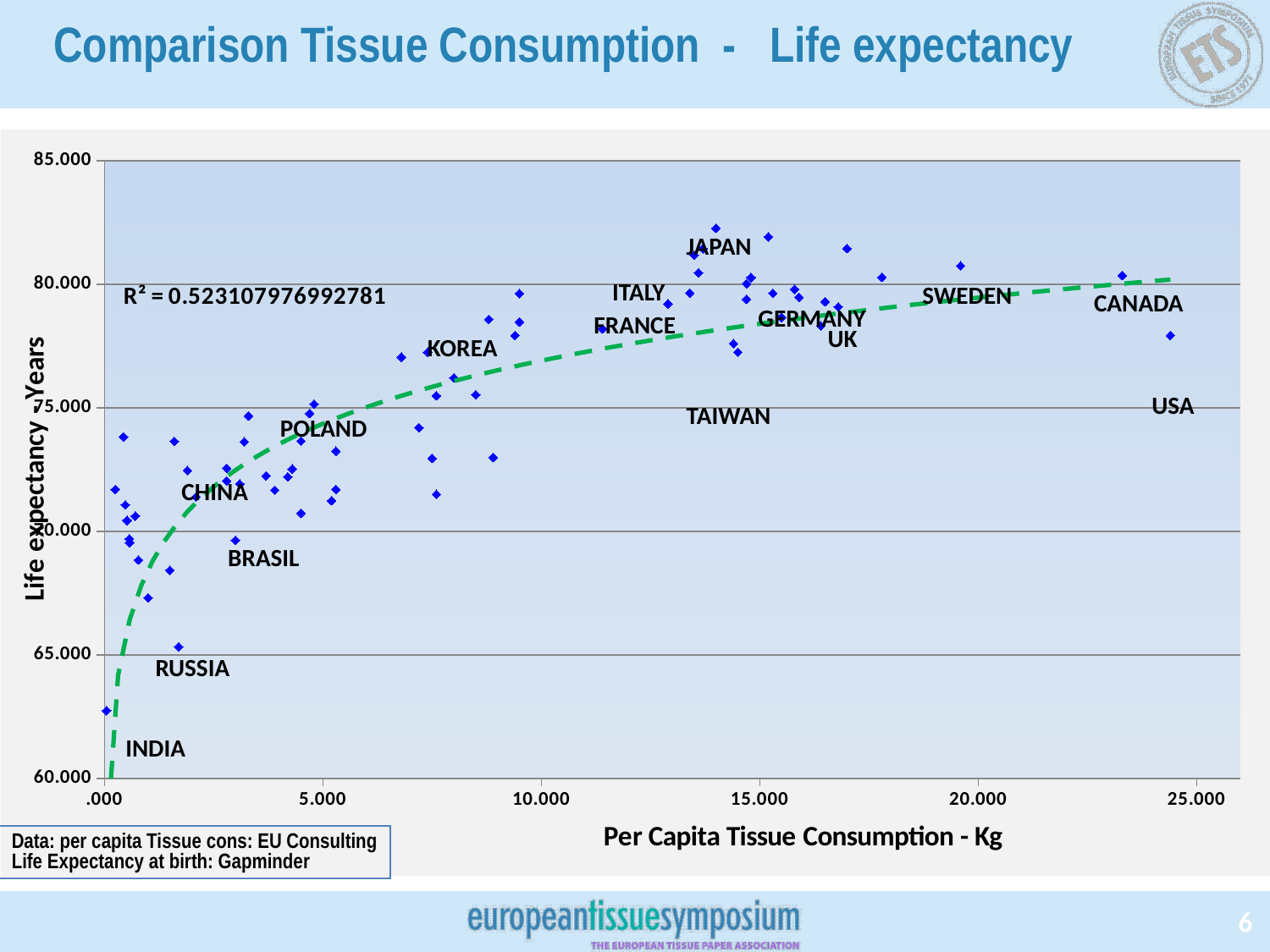
Which has the higher life expectancy, CHINA or INDIA? CHINA How many countries are labelled by name on the chart? 15 What kind of chart is shown on the slide? scatter chart What is the title of the chart's x axis? Per Capita Tissue Consumption - Kg Do life expectancy values generally rise or fall as per capita tissue consumption increases along the x axis? rise Is the life expectancy value for USA greater or less than 80.000? less Which labelled country has the lowest life expectancy on the chart? INDIA Is the life expectancy value for INDIA greater or less than 65.000? less Is the per capita tissue consumption for USA greater or less than 20.000? greater What is the R² value printed on the chart? R² = 0.523107976992781 Which labelled country has the highest per capita tissue consumption on the chart? USA What is the title of the chart's y axis? Life expectancy - Years